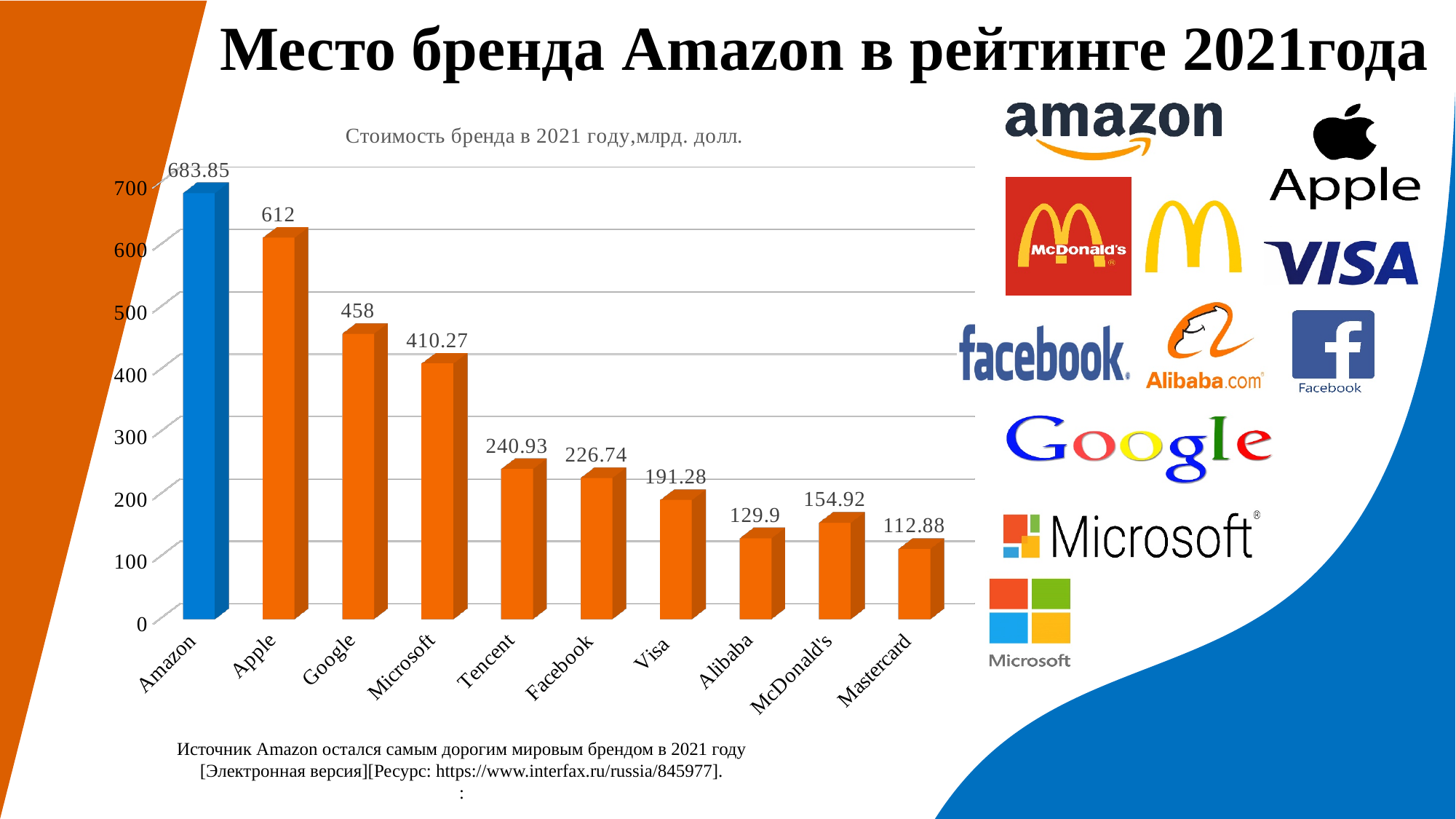
What is the brand value shown for McDonald's? 154.92 Which brand has the lowest value in the chart? Mastercard What type of chart is shown on the slide? bar chart What is the title of the chart? Стоимость бренда в 2021 году,млрд. долл. Do the values generally rise or fall from Amazon to Mastercard along the x axis? fall Which has a larger value, Alibaba or McDonald's? McDonald's Which brand has the highest value in the chart? Amazon What is the difference between the values for Apple and Google? 154 Is the value for Tencent greater or less than 200? greater What is the brand value shown for Amazon? 683.85 How many brands are shown in the chart? 10 What is the brand value shown for Microsoft? 410.27